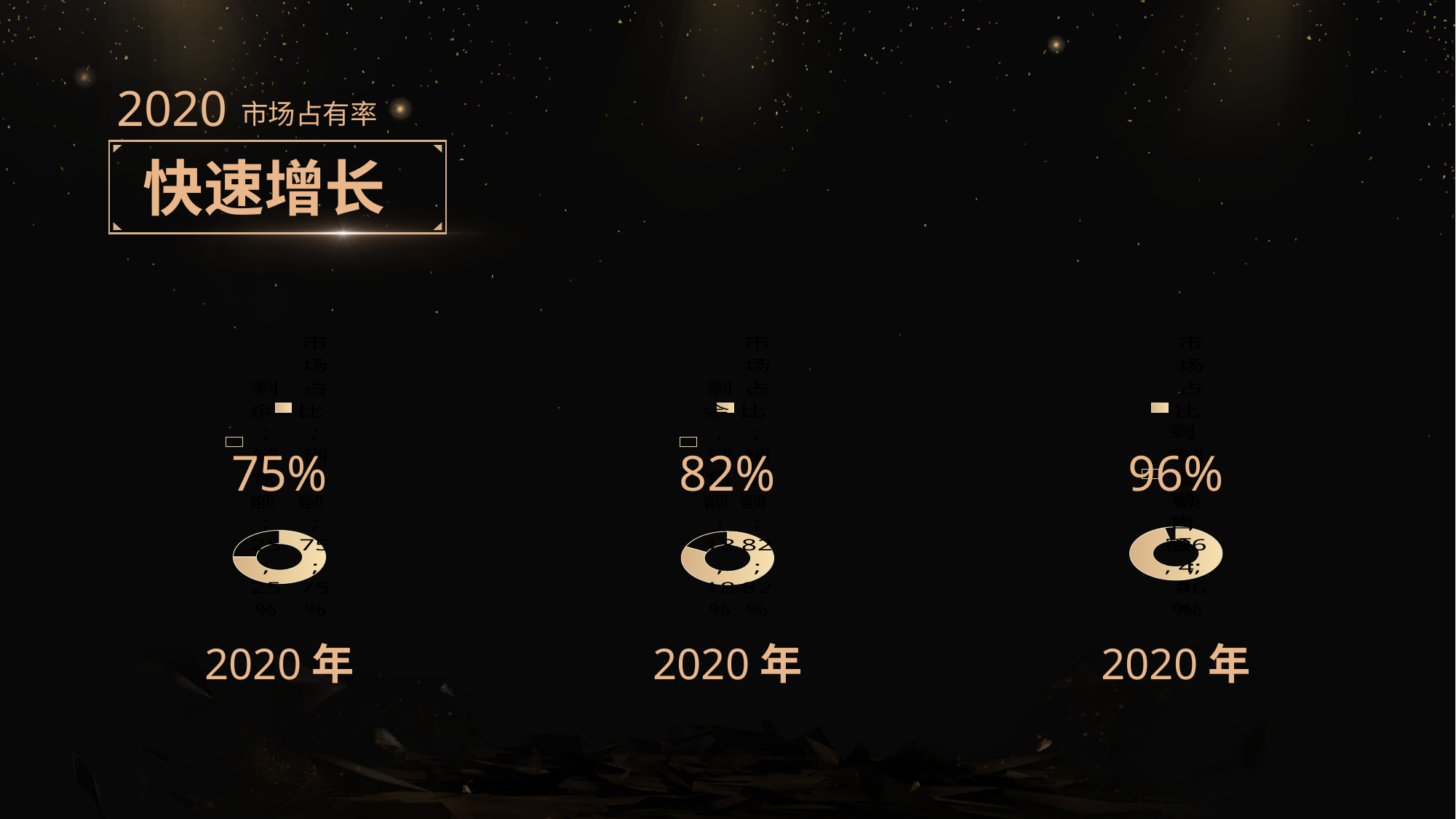
What kind of chart is shown on the left of the slide? doughnut chart Is the main share in the middle doughnut chart larger or smaller than the main share in the left doughnut chart? larger In the right doughnut chart, what share does the smaller slice represent? 4% In the middle doughnut chart, what share does the larger slice represent? 82% Which of the three doughnut charts shows the smallest main share? the left chart (75%) In the middle doughnut chart, what share does the smaller slice represent? 18% Which of the three doughnut charts shows the largest main share? the right chart (96%) How many doughnut charts are on the slide? 3 What is the difference between the main share in the right doughnut chart and the main share in the left doughnut chart? 21%